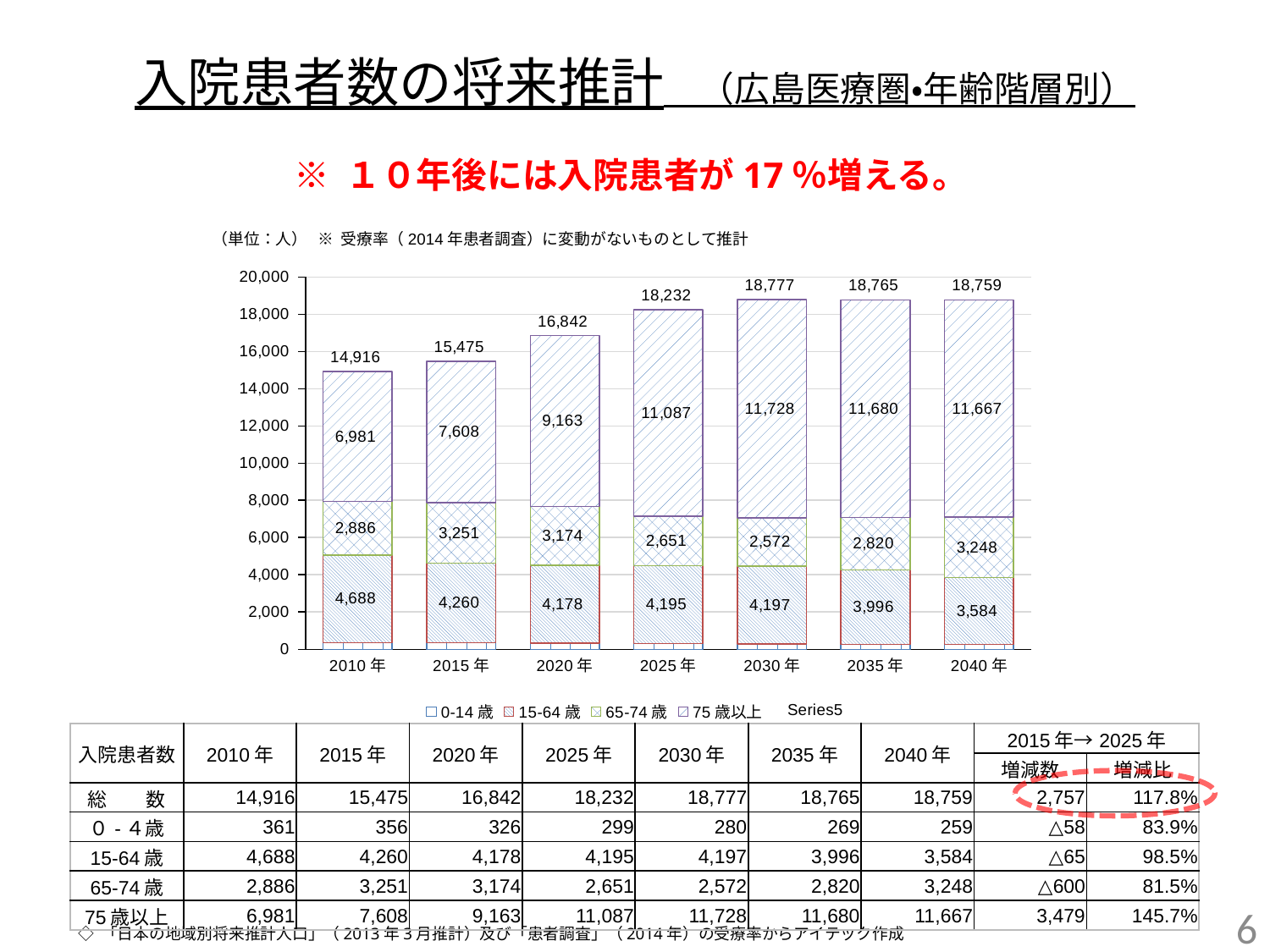
Which is larger, the 75歳以上 segment in 2025年 or the 75歳以上 segment in 2015年? 2025年 Which year has the highest total number of inpatients in the chart? 2030年 What is the value for the 15-64歳 segment in the 2040年 bar? 3,584 Does the 75歳以上 segment rise or fall from 2010年 to 2030年? Rise What is the value for the 75歳以上 segment in the 2020年 bar? 9,163 What is the total number of inpatients shown above the bar for 2025年? 18,232 Which year has the lowest total number of inpatients in the chart? 2010年 How many years (bars) are plotted on the x axis? 7 What is the value for the 65-74歳 segment in the 2015年 bar? 3,251 How many entries does the legend list? 5 What is the difference between the total for 2030年 and the total for 2010年? 3,861 What type of chart is shown on the slide? Stacked bar chart